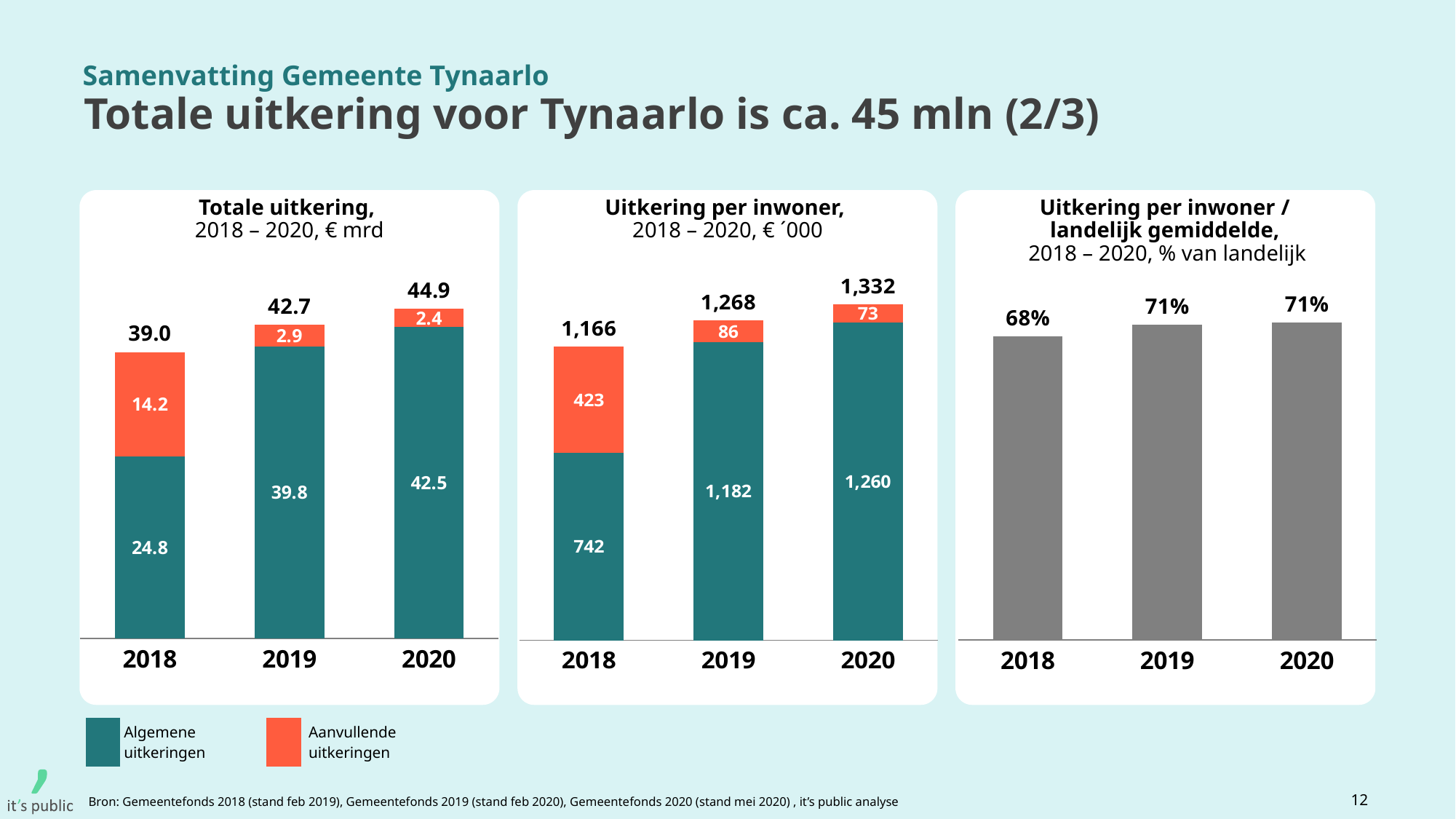
In the 'Totale uitkering' chart, what is the difference between the Algemene uitkeringen values for 2020 and 2018? 17.7 How many series does the legend at the bottom of the slide list? 2 In the 'Uitkering per inwoner' chart, what is the value of Aanvullende uitkeringen for 2018? 423 In the 'Uitkering per inwoner / landelijk gemiddelde' chart, what is the value for 2018? 68% In the 'Uitkering per inwoner' chart, is the Algemene uitkeringen value for 2019 larger or smaller than for 2020? smaller In the 'Totale uitkering' chart, what is the value of Aanvullende uitkeringen for 2019? 2.9 In the 'Totale uitkering' chart, what is the value of Algemene uitkeringen for 2018? 24.8 In the 'Uitkering per inwoner / landelijk gemiddelde' chart, how many bars are shown? 3 In the 'Uitkering per inwoner' chart, which year has the highest total? 2020 In the 'Uitkering per inwoner' chart, what is the total for 2019? 1,268 In the 'Totale uitkering' chart, which year has the lowest total? 2018 In the 'Totale uitkering' chart, what is the total of the stacked bar for 2020? 44.9